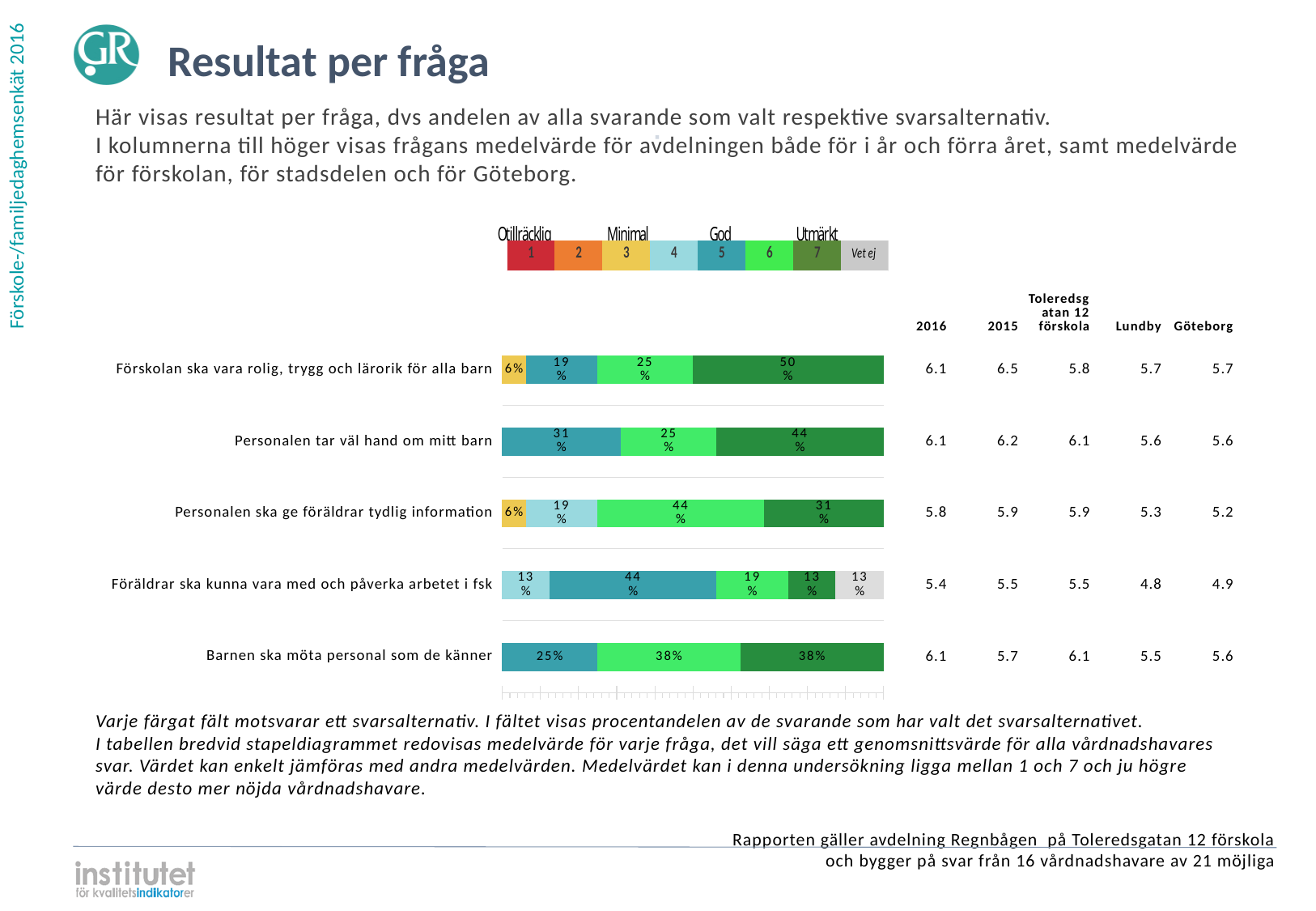
How many response categories does the colour legend above the chart show, including "Vet ej"? 8 What is the difference between the rating-7 share for "Personalen tar väl hand om mitt barn" (44%) and for "Personalen ska ge föräldrar tydlig information" (31%)? 13 percentage points What percentage chose rating 6 (light green) for "Personalen ska ge föräldrar tydlig information"? 44% What percentage of respondents chose the highest rating (7, dark green) for "Förskolan ska vara rolig, trygg och lärorik för alla barn"? 50% What kind of chart is shown on the slide? Stacked bar chart What is the 2016 mean value shown for "Föräldrar ska kunna vara med och påverka arbetet i fsk"? 5.4 What percentage chose rating 5 (teal) for "Personalen tar väl hand om mitt barn"? 31% How many questions (categories) are plotted in the bar chart? 5 Which question has the smallest share of respondents choosing the highest rating (7, dark green)? Föräldrar ska kunna vara med och påverka arbetet i fsk What share of respondents answered "Vet ej" for "Föräldrar ska kunna vara med och påverka arbetet i fsk"? 13% For "Barnen ska möta personal som de känner", is the share for rating 5 (25%) larger or smaller than the share for rating 6 (38%)? Smaller Which question has the largest share of respondents choosing the highest rating (7, dark green)? Förskolan ska vara rolig, trygg och lärorik för alla barn